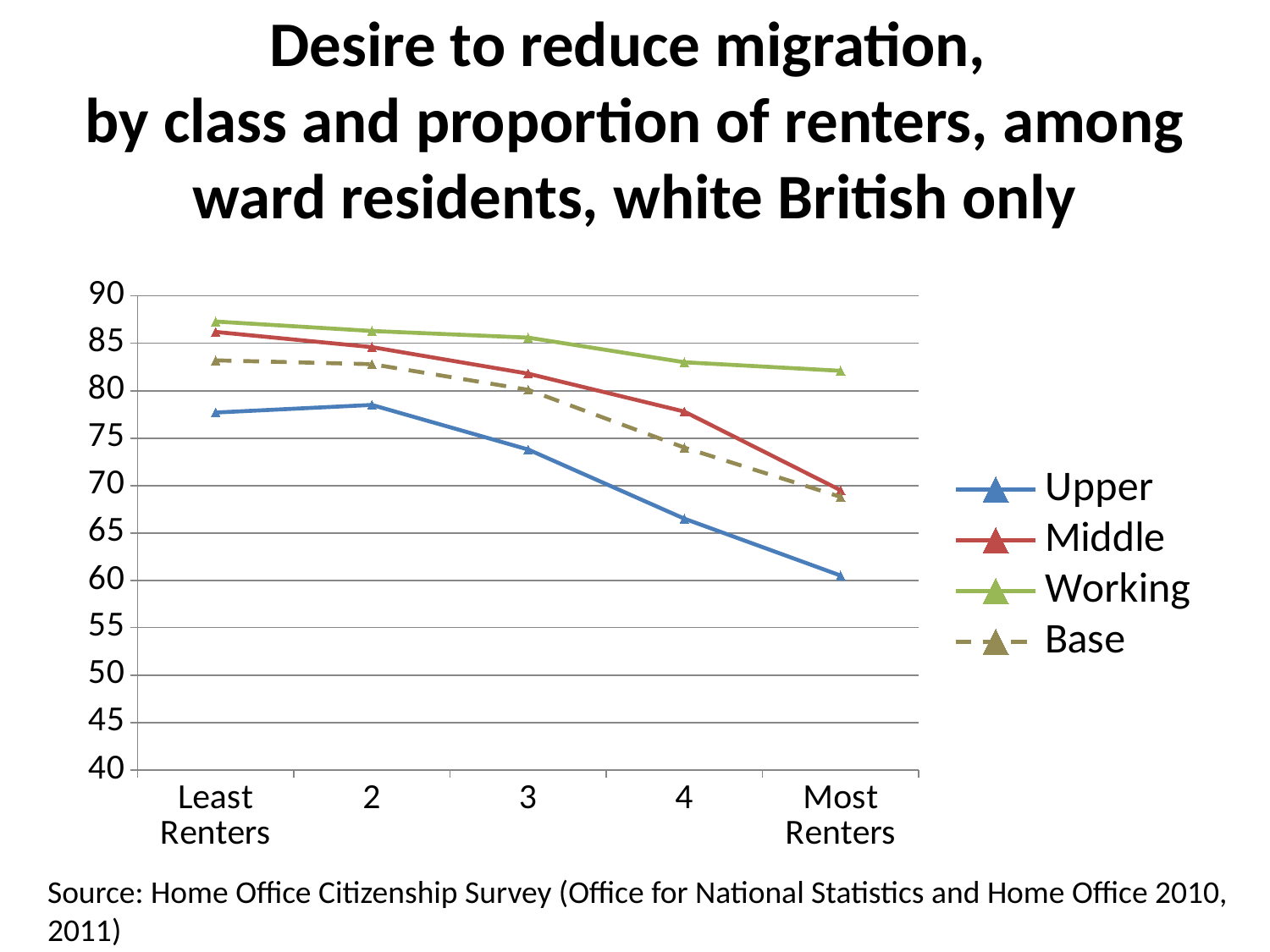
Which series is drawn with a dashed line? Base What kind of chart is shown on the slide? line chart How many series does the legend list? 4 How many categories are shown along the x axis? 5 Is the value for Working at Least Renters greater or less than 85? greater Does the Upper series generally rise or fall from Least Renters to Most Renters? fall Is the value for Upper at Most Renters greater or less than 65? less Which series has the lowest value at Most Renters? Upper Which series has the highest value at Most Renters? Working Is the value for Working at Most Renters greater or less than 80? greater Which is larger at Least Renters, the value for Upper or the value for Base? Base